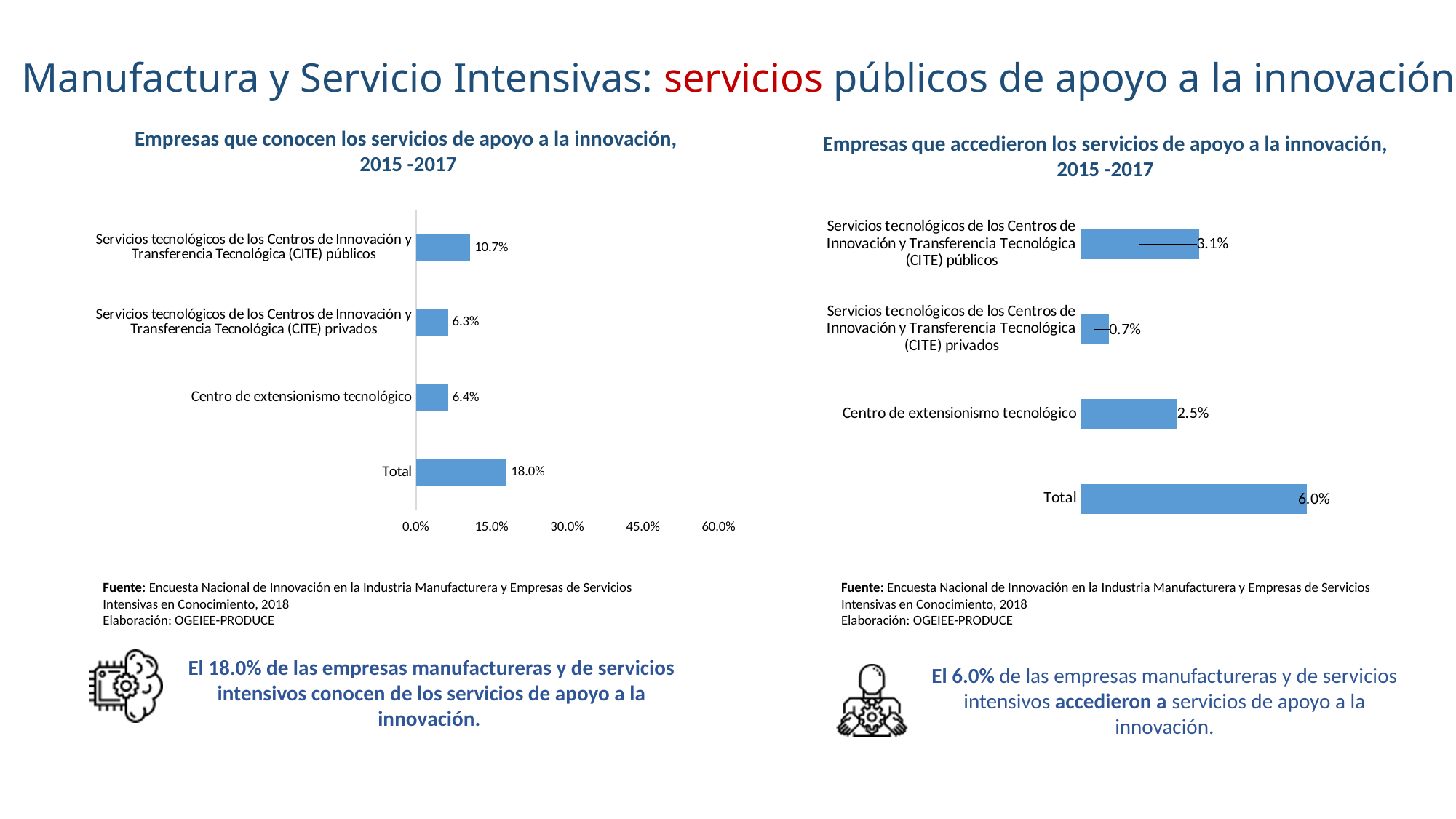
What type of chart is the right chart (Empresas que accedieron los servicios de apoyo a la innovación)? Bar chart In the right chart (Empresas que accedieron los servicios de apoyo a la innovación), which category has the lowest value? Servicios tecnológicos de los Centros de Innovación y Transferencia Tecnológica (CITE) privados In the right chart (Empresas que accedieron los servicios de apoyo a la innovación), what is the value for Centro de extensionismo tecnológico? 2.5% In the left chart (Empresas que conocen los servicios de apoyo a la innovación), what is the value for Total? 18.0% In the right chart (Empresas que accedieron los servicios de apoyo a la innovación), what is the difference between the CITE públicos value and the CITE privados value? 2.4% In the left chart (Empresas que conocen los servicios de apoyo a la innovación), what is the difference between the Total value and the CITE públicos value? 7.3% In the left chart (Empresas que conocen los servicios de apoyo a la innovación), what is the value for Servicios tecnológicos de los CITE públicos? 10.7% In the right chart (Empresas que accedieron los servicios de apoyo a la innovación), what is the value for Servicios tecnológicos de los CITE privados? 0.7% In the right chart (Empresas que accedieron los servicios de apoyo a la innovación), which is larger: CITE públicos or Centro de extensionismo tecnológico? CITE públicos In the left chart (Empresas que conocen los servicios de apoyo a la innovación), is the value for Total greater or less than 15.0%? greater In the left chart (Empresas que conocen los servicios de apoyo a la innovación), which category has the highest value? Total How many categories are shown in the left chart (Empresas que conocen los servicios de apoyo a la innovación)? 4